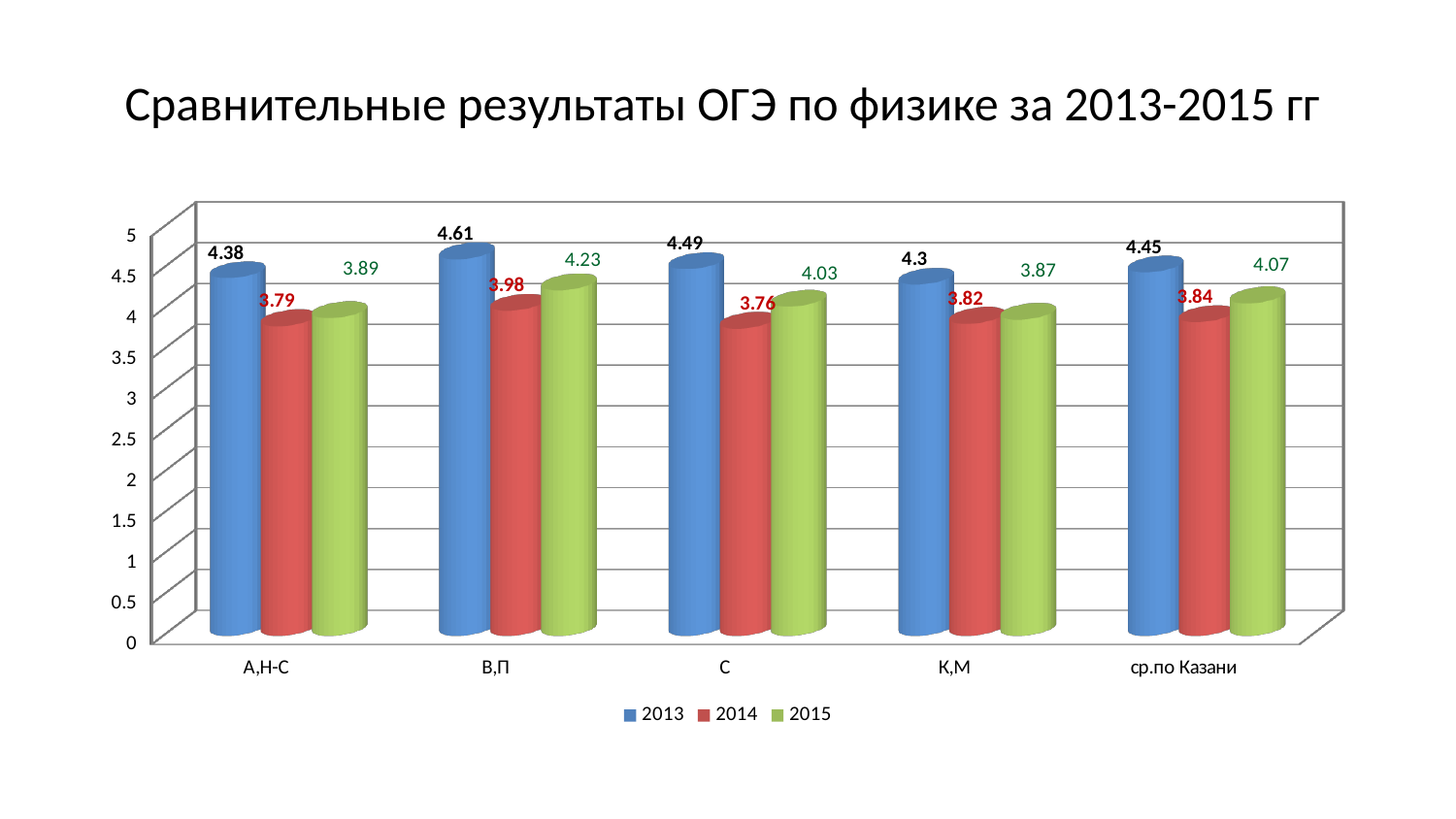
Which category has the lowest value in the 2014 series? С Is the 2015 value for В,П greater or less than 4? greater How many categories are shown on the x axis? 5 Which category has the highest value in the 2013 series? В,П What is the title of the chart? Сравнительные результаты ОГЭ по физике за 2013-2015 гг What kind of chart is shown on the slide? bar chart What is the value for С in the 2014 series? 3.76 What is the difference between the 2013 and 2014 values for А,Н-С? 0.59 Which is larger for К,М: the 2014 value or the 2015 value? 2015 How many series does the legend list? 3 What is the value for ср.по Казани in the 2015 series? 4.07 What is the value for В,П in the 2013 series? 4.61